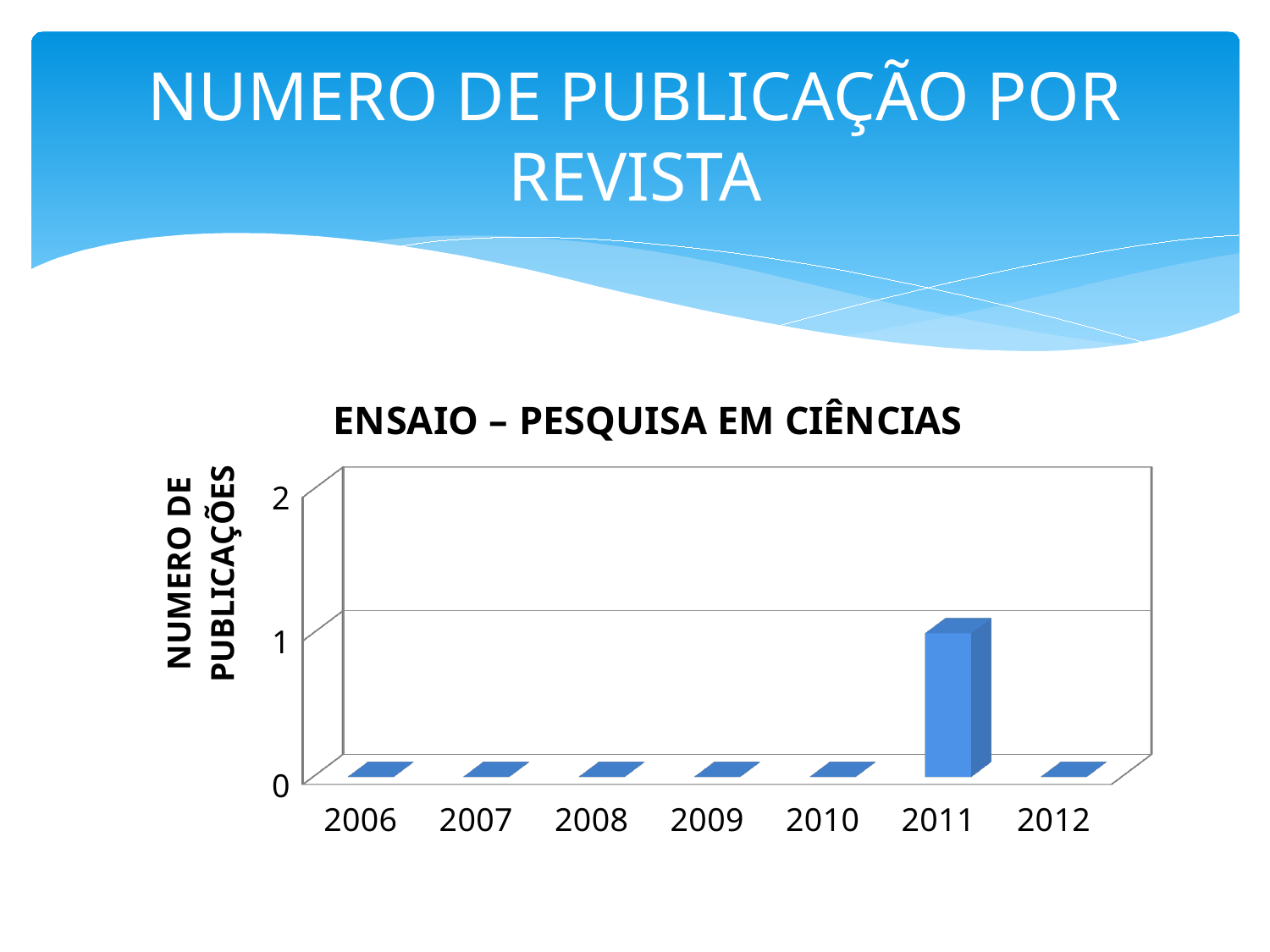
What kind of chart is shown on the slide? bar chart What is the number of publications for 2012? 0 What is the number of publications for 2011? 1 What is the number of publications for 2008? 0 Is the value for 2011 greater or less than 2? less Which year has the highest number of publications? 2011 How many years are shown on the x axis? 7 What is the label of the vertical axis? NUMERO DE PUBLICAÇÕES Which is larger, the value for 2011 or the value for 2010? 2011 What is the title of the chart? ENSAIO – PESQUISA EM CIÊNCIAS What is the first year shown on the x axis? 2006 What is the difference between the values for 2011 and 2006? 1